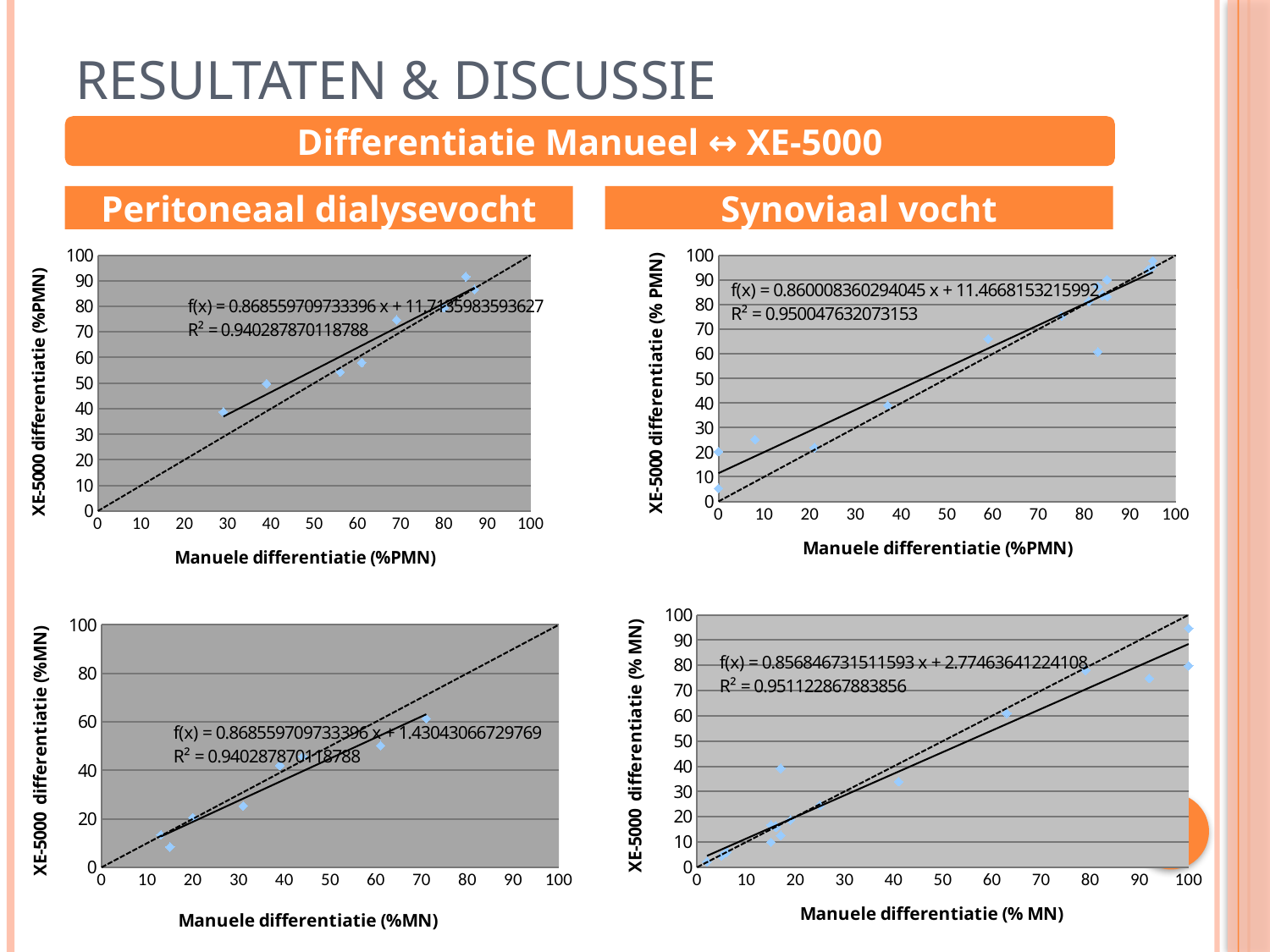
What is the y-axis title of the top-left chart (Peritoneaal dialysevocht)? XE-5000 differentiatie (%PMN) In the bottom-left chart (Peritoneaal dialysevocht, %MN), what is the slope of the fitted line f(x) shown on the chart? 0.868559709733396 What is the x-axis title of the bottom-right chart (Synoviaal vocht, %MN)? Manuele differentiatie (% MN) In the top-left chart (Peritoneaal dialysevocht, %PMN), is the XE-5000 value for the point with the lowest manual differentiation greater or less than 50? less Which has the higher printed R² value: the top-left chart (Peritoneaal dialysevocht, %PMN) or the top-right chart (Synoviaal vocht, %PMN)? top-right chart (Synoviaal vocht, %PMN) In the bottom-left chart (Peritoneaal dialysevocht, %MN), is the XE-5000 value for the point with the highest manual differentiation greater or less than 50? greater In the bottom-right chart (Synoviaal vocht, %MN), what is the R² value printed on the chart? 0.951122867883856 In the top-left chart (Peritoneaal dialysevocht, %PMN), how many data points are plotted? 8 How many charts are shown on the slide? 4 In the top-left chart (Peritoneaal dialysevocht, %PMN), what is the R² value printed on the chart? 0.940287870118788 What kind of chart is the top-left chart under 'Peritoneaal dialysevocht'? scatter chart In the top-right chart (Synoviaal vocht, %PMN), what is the R² value printed on the chart? 0.950047632073153